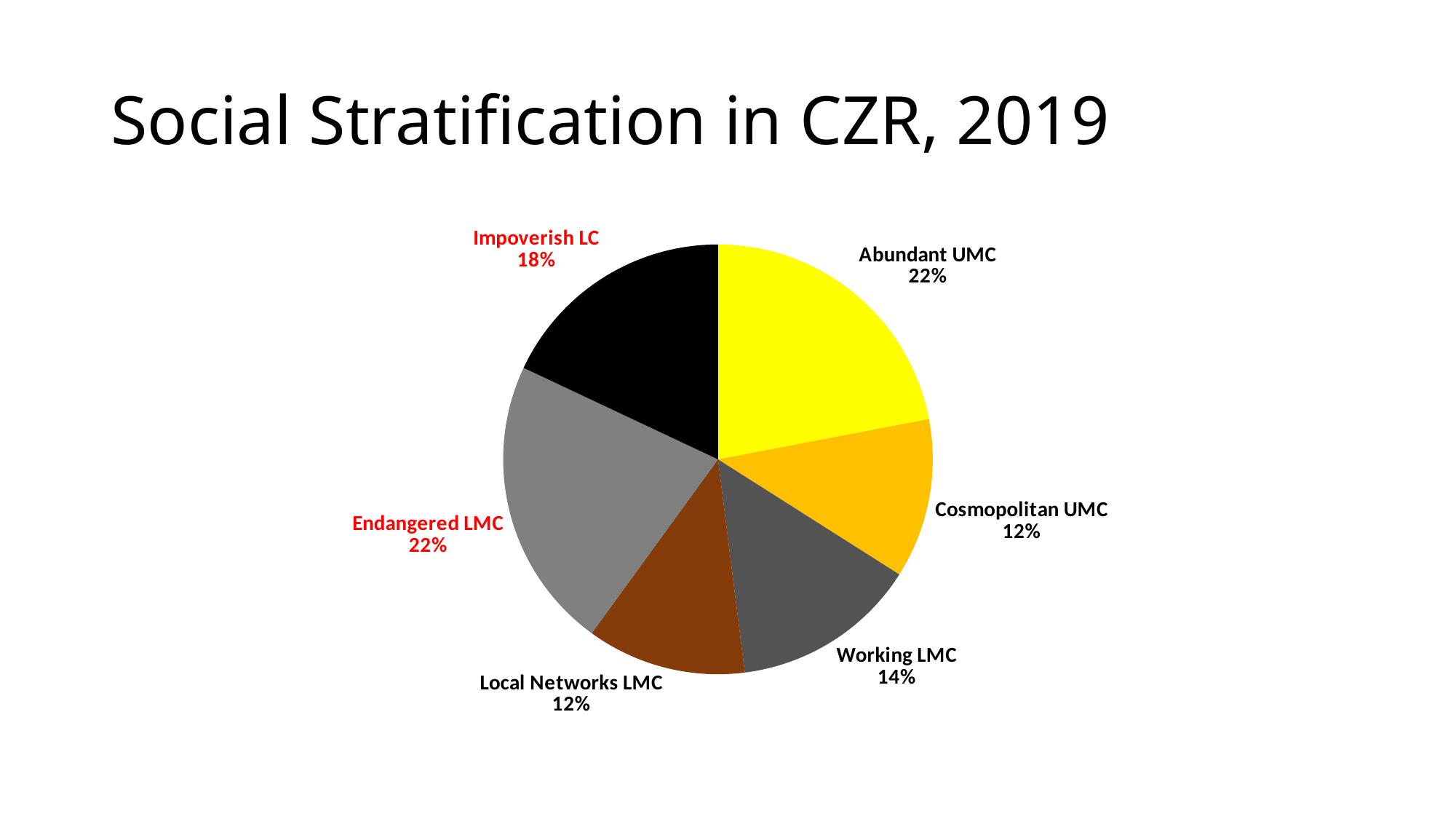
Which is larger, Cosmopolitan UMC or Abundant UMC? Abundant UMC Which slice of the pie is coloured black? Impoverish LC How many slices does the pie chart have? 6 What is the value shown for Local Networks LMC? 12% Which is larger, Impoverish LC or Working LMC? Impoverish LC What share of the pie is Working LMC? 14% What is the value shown for Endangered LMC? 22% What is the title of the chart on the slide? Social Stratification in CZR, 2019 What share of the pie is Impoverish LC? 18% What is the value shown for Cosmopolitan UMC? 12% What is the difference between the shares of Abundant UMC and Working LMC? 8% What kind of chart is shown on the slide? pie chart